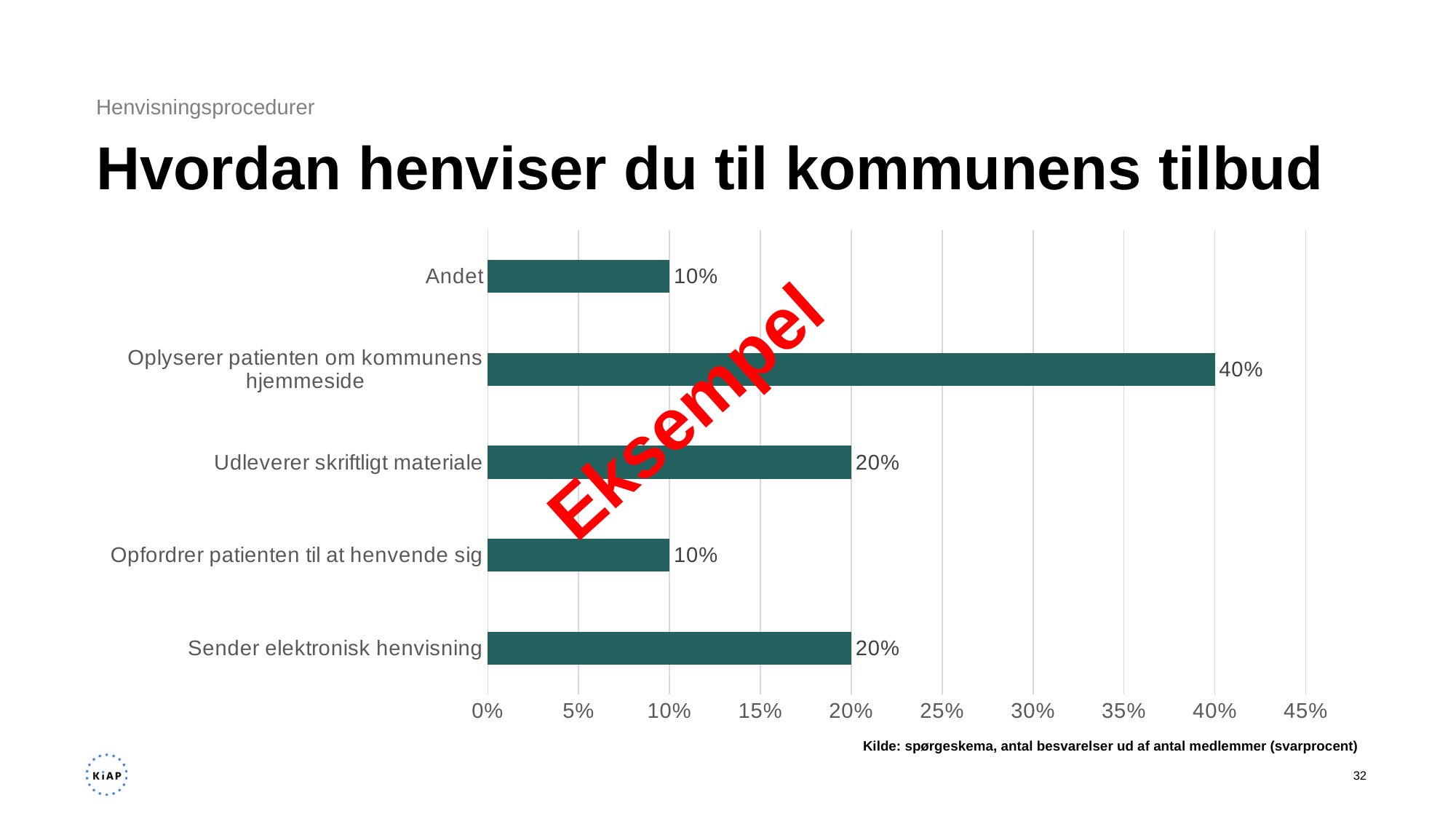
What is the title of the slide? Hvordan henviser du til kommunens tilbud What is the difference between "Oplyserer patienten om kommunens hjemmeside" and "Udleverer skriftligt materiale"? 20% How many categories are shown in the chart? 5 What is the value for "Andet"? 10% What is the value for "Opfordrer patienten til at henvende sig"? 10% What is the value for "Oplyserer patienten om kommunens hjemmeside"? 40% What is the value for "Sender elektronisk henvisning"? 20% Which is larger: "Udleverer skriftligt materiale" or "Andet"? Udleverer skriftligt materiale Which category has the highest value? Oplyserer patienten om kommunens hjemmeside What is the highest value shown on the x axis? 45% What kind of chart is shown on the slide? bar chart Is the value for "Oplyserer patienten om kommunens hjemmeside" greater or less than 30%? greater